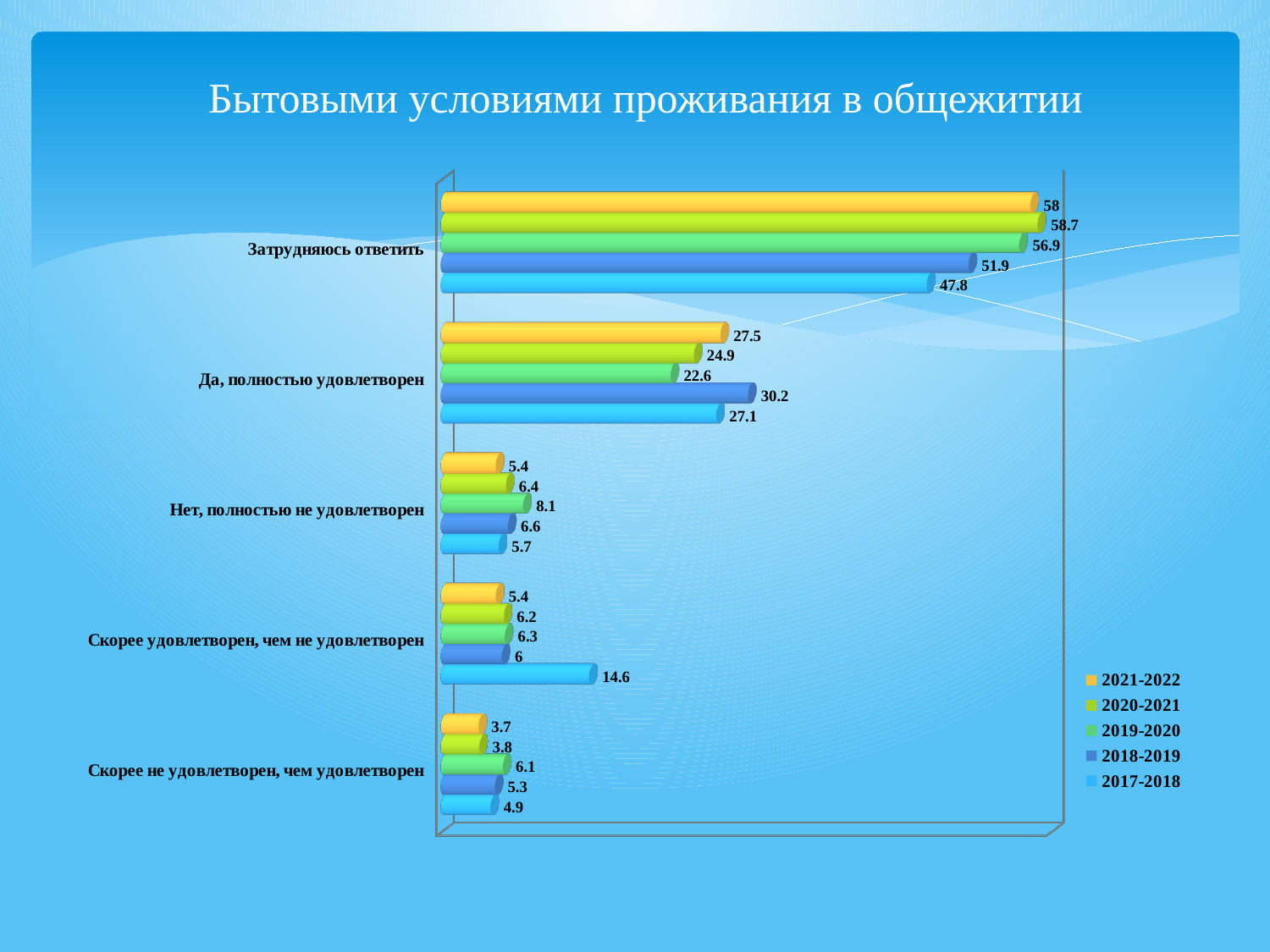
What is the value for "Да, полностью удовлетворен" in the 2018-2019 series? 30.2 What is the title of the slide? Бытовыми условиями проживания в общежитии How many categories are shown on the chart? 5 What is the difference between the 2018-2019 and 2017-2018 values for "Затрудняюсь ответить"? 4.1 What kind of chart is shown on the slide? Bar chart Which category has the lowest value in the 2020-2021 series? Скорее не удовлетворен, чем удовлетворен Which category has the highest value in the 2021-2022 series? Затрудняюсь ответить For "Да, полностью удовлетворен", which is larger: the 2021-2022 value or the 2019-2020 value? 2021-2022 What is the value for "Скорее удовлетворен, чем не удовлетворен" in the 2017-2018 series? 14.6 What is the value for "Нет, полностью не удовлетворен" in the 2019-2020 series? 8.1 What is the value for "Затрудняюсь ответить" in the 2017-2018 series? 47.8 How many series does the legend list? 5